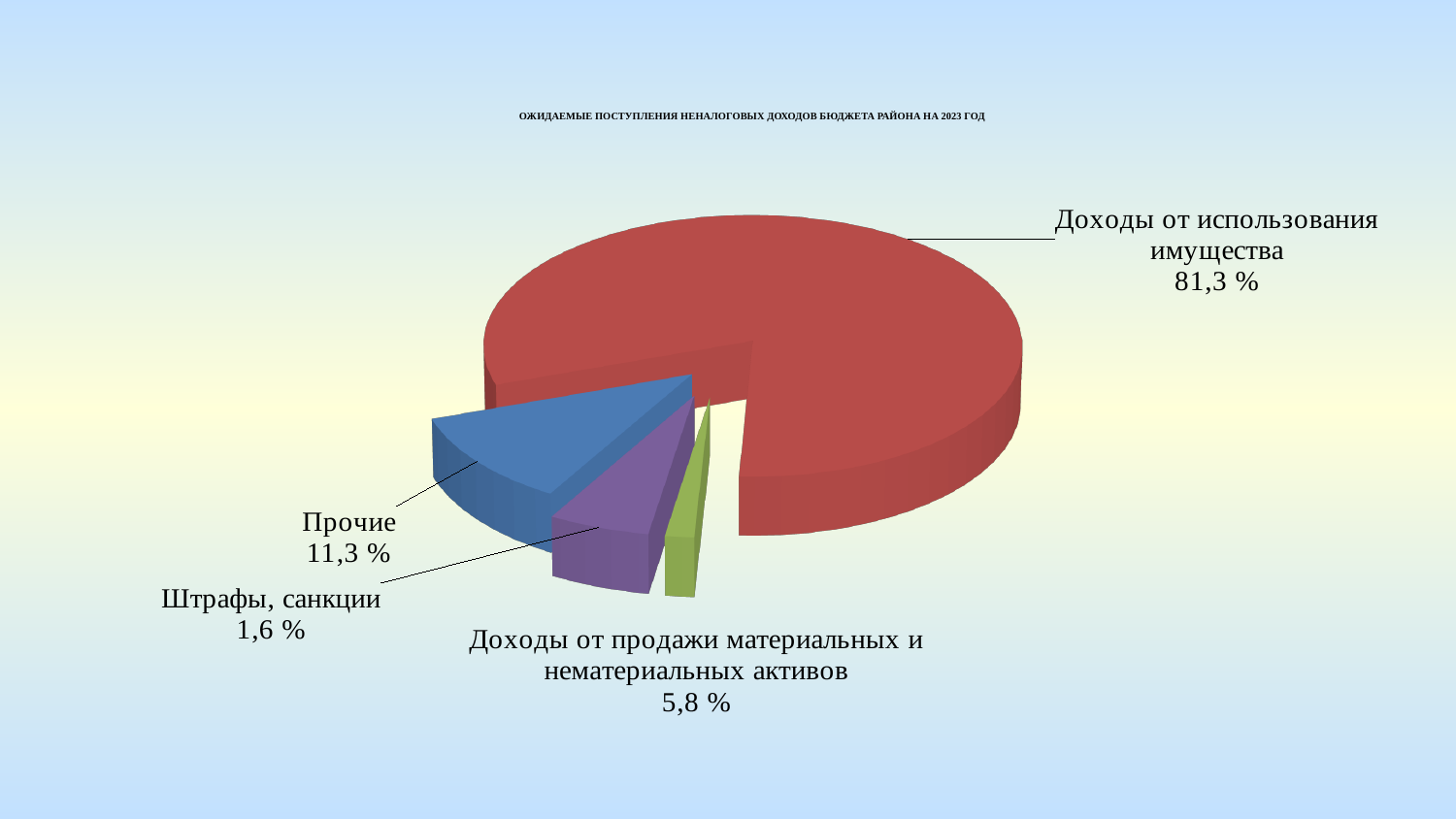
What is the value shown for "Штрафы, санкции"? 1,6 % How many categories are shown in the pie chart? 4 What is the value shown for "Прочие"? 11,3 % What share of the pie does "Доходы от использования имущества" have? 81,3 % What is the value shown for "Доходы от продажи материальных и нематериальных активов"? 5,8 % What kind of chart is shown on the slide? pie chart Which category has the largest share of the pie? Доходы от использования имущества Which is larger: the share for "Прочие" or the share for "Доходы от продажи материальных и нематериальных активов"? Прочие What is the difference in percentage points between "Прочие" and "Штрафы, санкции"? 9,7 Which category has the smallest share of the pie? Штрафы, санкции What colour is the largest slice of the pie? red What is the difference in percentage points between "Доходы от использования имущества" and "Прочие"? 70